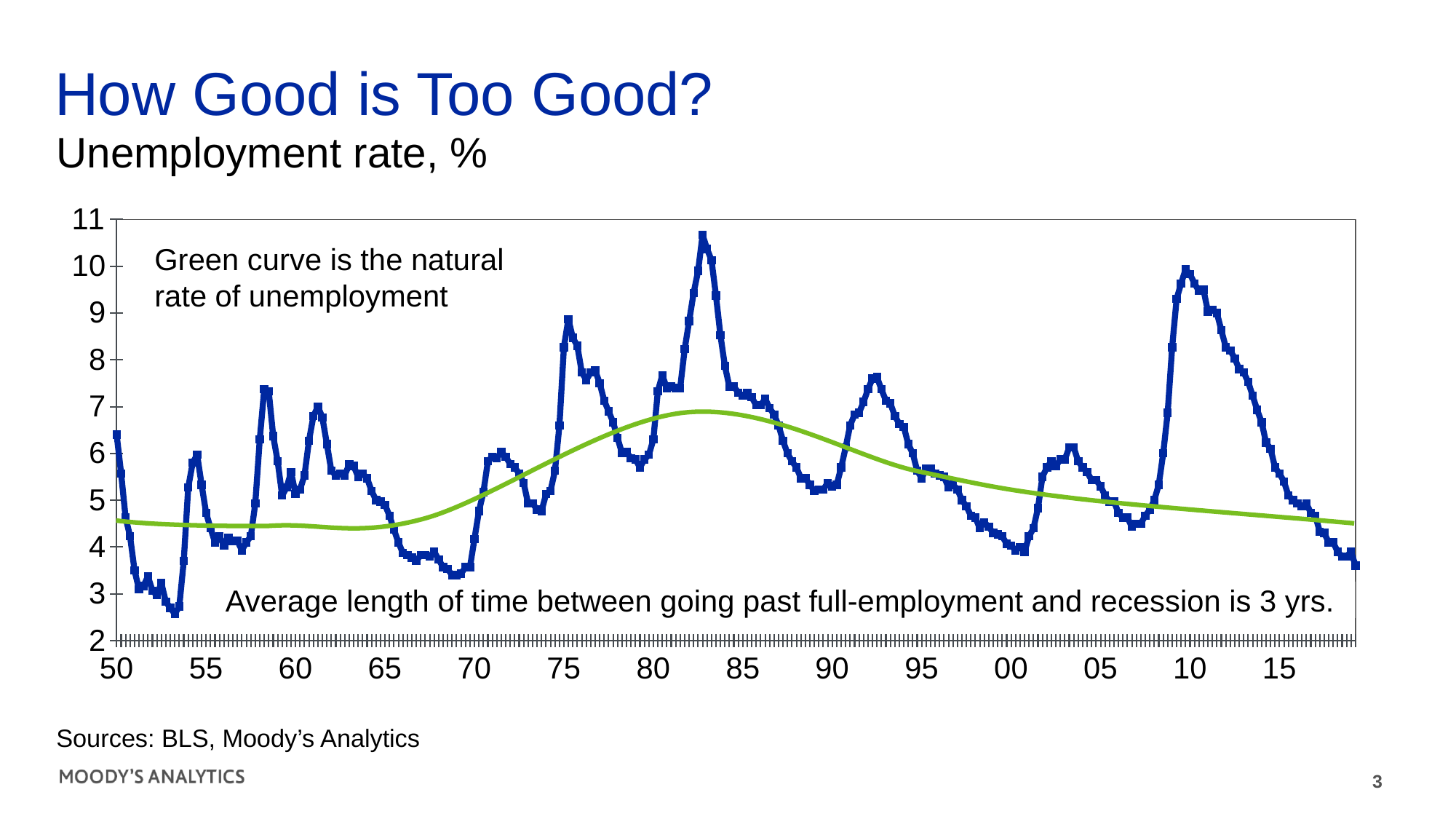
How many curves are plotted on the chart? 2 Is the lowest value of the unemployment rate around 1953 greater or less than 3? less What is the subtitle describing the quantity plotted on the chart? Unemployment rate, % According to the annotation on the chart, what does the green curve represent? the natural rate of unemployment What kind of chart is shown on the slide? line chart Is the peak value of the unemployment rate around 2010 greater or less than 9? greater Is the value of the green natural rate curve at 1950 greater or less than 5? less Which peak of the unemployment rate is higher, the one around 1975 or the one around 1983? around 1983 Does the blue unemployment rate line rise or fall between 2010 and 2019? fall